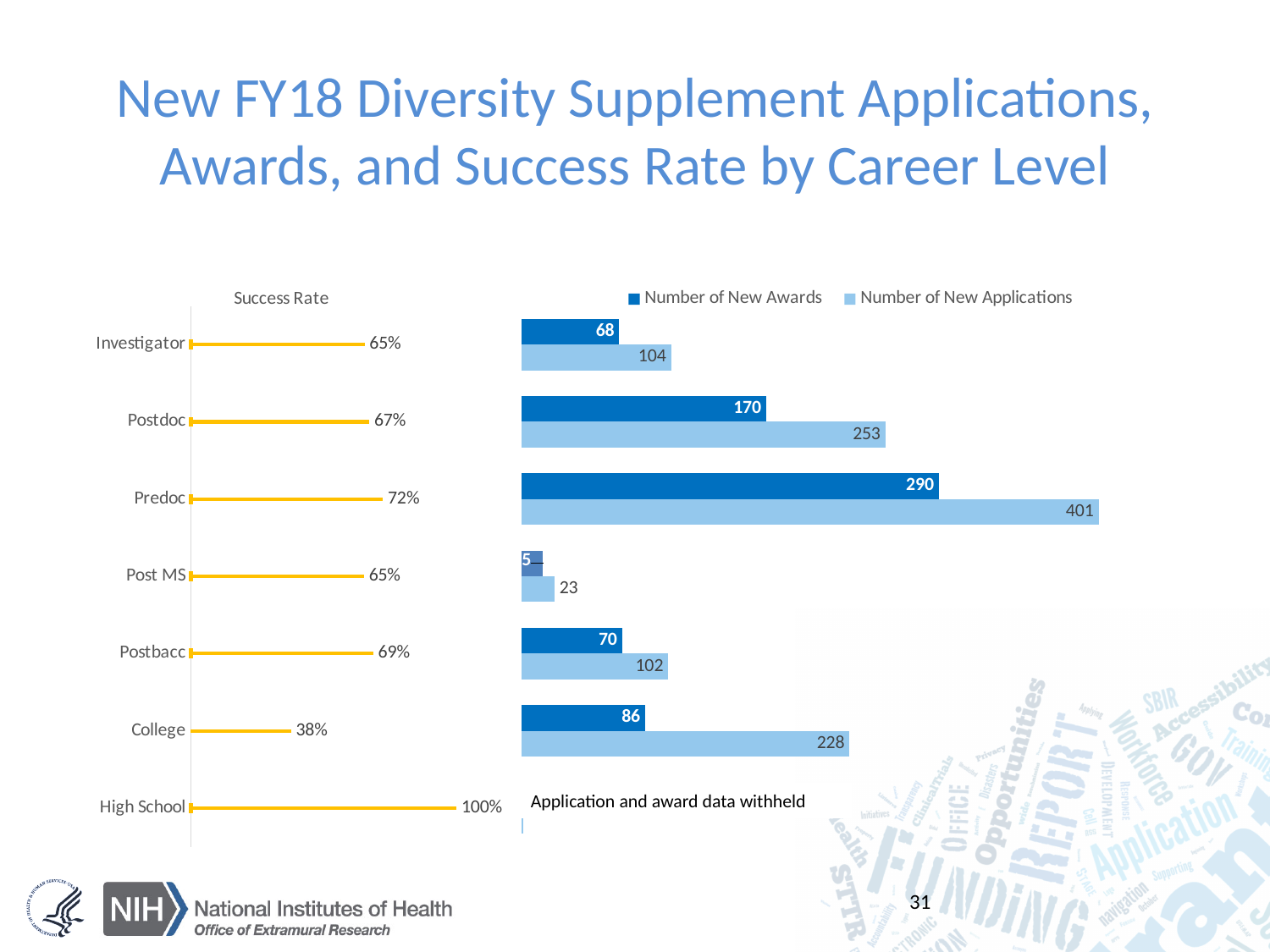
How many series does the legend of the right-hand chart list? 2 In the Success Rate chart, what is the difference between the success rates for Postbacc and College? 31% In the Success Rate chart, which career level has the highest success rate? High School In the Success Rate chart, how many career levels are listed on the axis? 7 In the right-hand chart, which career level has the fewest new applications? Post MS What type of chart is the right-hand chart? Bar chart In the right-hand chart, how many new applications were there for Predoc? 401 In the Success Rate chart, which career level has the lowest success rate? College In the Success Rate chart, what is the success rate for Predoc? 72% In the right-hand chart, what is the difference between the number of new applications and new awards for College? 142 In the right-hand chart, how many new awards were there for Postdoc? 170 In the right-hand chart, which is larger: the number of new awards for Investigator or for Postbacc? Postbacc